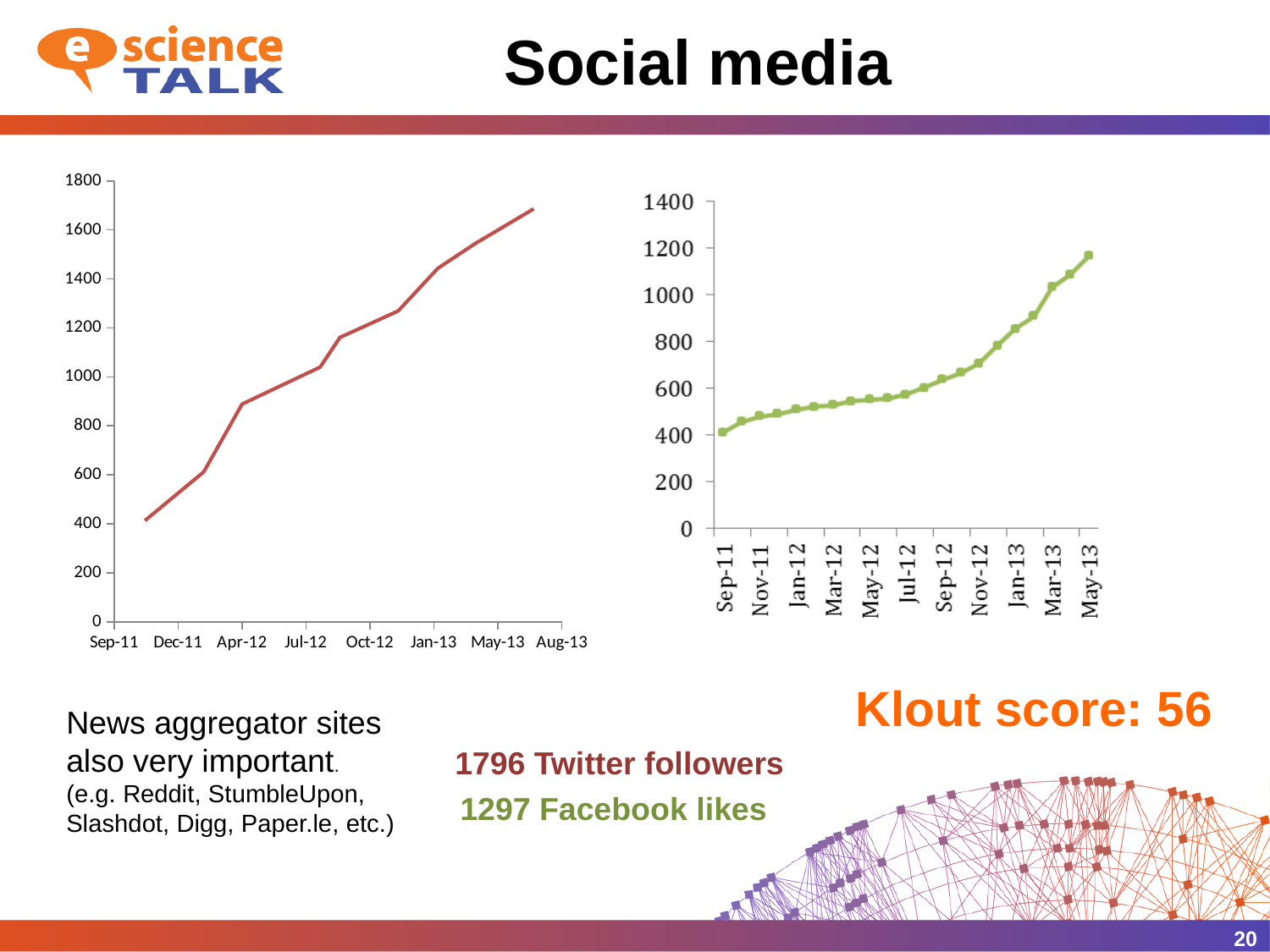
In the chart on the left, is the value at Sep-11 greater or less than 600? less In the chart on the left, is the value at Aug-13 greater or less than 1600? greater In the chart on the right, is the value at May-13 greater or less than 1000? greater In the chart on the left, do the values rise or fall from Sep-11 to Aug-13? rise What kind of chart is the chart on the right of the slide? line chart What kind of chart is the chart on the left of the slide? line chart In the chart on the right, do the values rise or fall from Sep-11 to May-13? rise In the chart on the left, which is larger, the value at Sep-11 or the value at Aug-13? Aug-13 What is the highest value shown on the y axis of the chart on the left? 1800 How many date labels are shown on the x axis of the chart on the right? 11